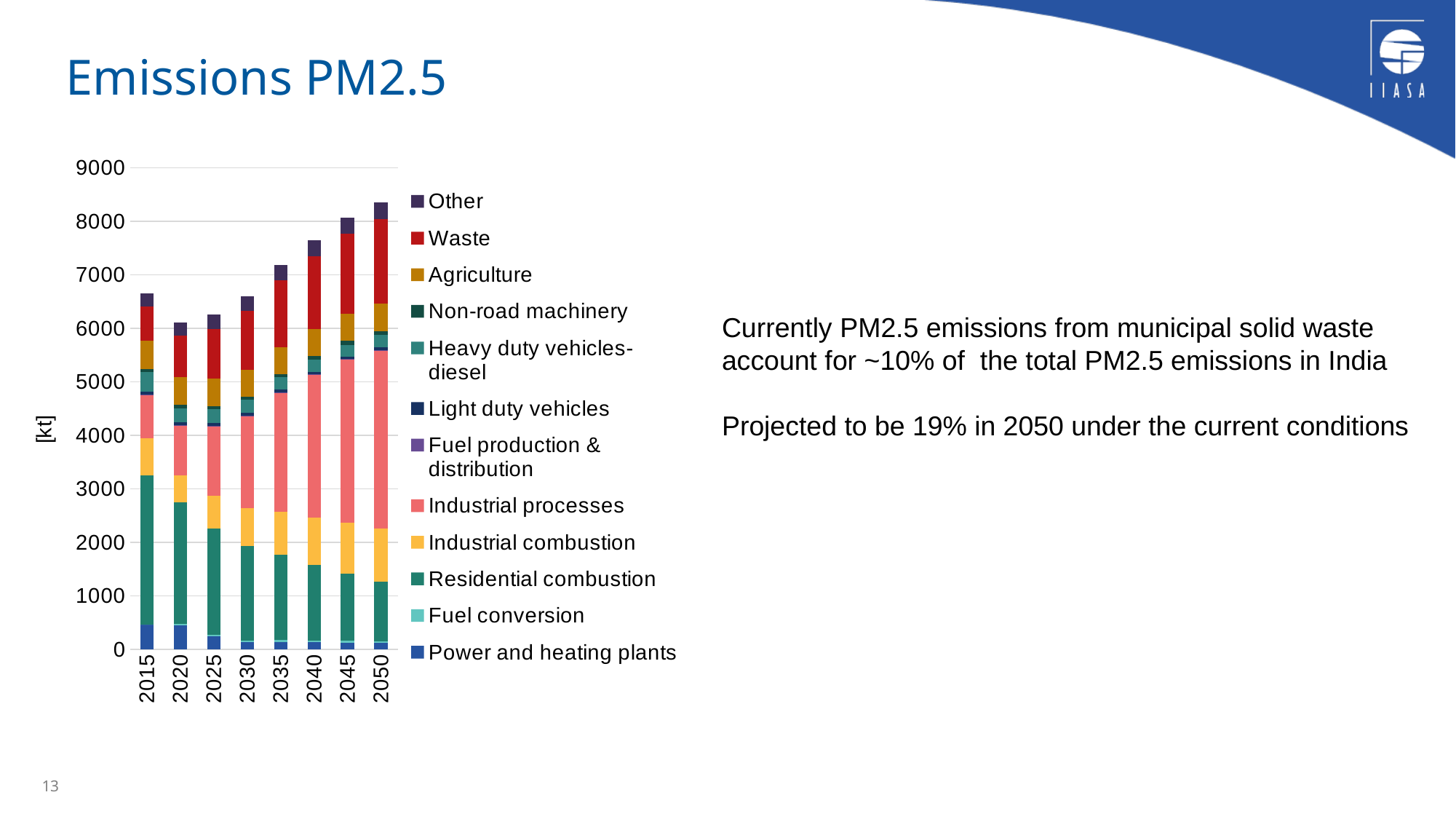
Is the total PM2.5 emissions bar for 2050 greater or less than 8000? greater What kind of chart is shown on the slide? Stacked bar chart How many series does the chart's legend list? 12 What unit is shown on the y axis of the chart? [kt] Is the total PM2.5 emissions bar for 2020 greater or less than 7000? less How many years are shown on the x axis of the chart? 8 Which year has the highest total PM2.5 emissions in the chart? 2050 Do the total PM2.5 emissions rise or fall from 2020 to 2050? rise Which legend entry is listed first (at the top) in the chart's legend? Other Which year has the larger total PM2.5 emissions, 2015 or 2050? 2050 Is the total PM2.5 emissions bar for 2040 greater or less than 7000? greater Does the Residential combustion segment rise or fall from 2015 to 2050? fall